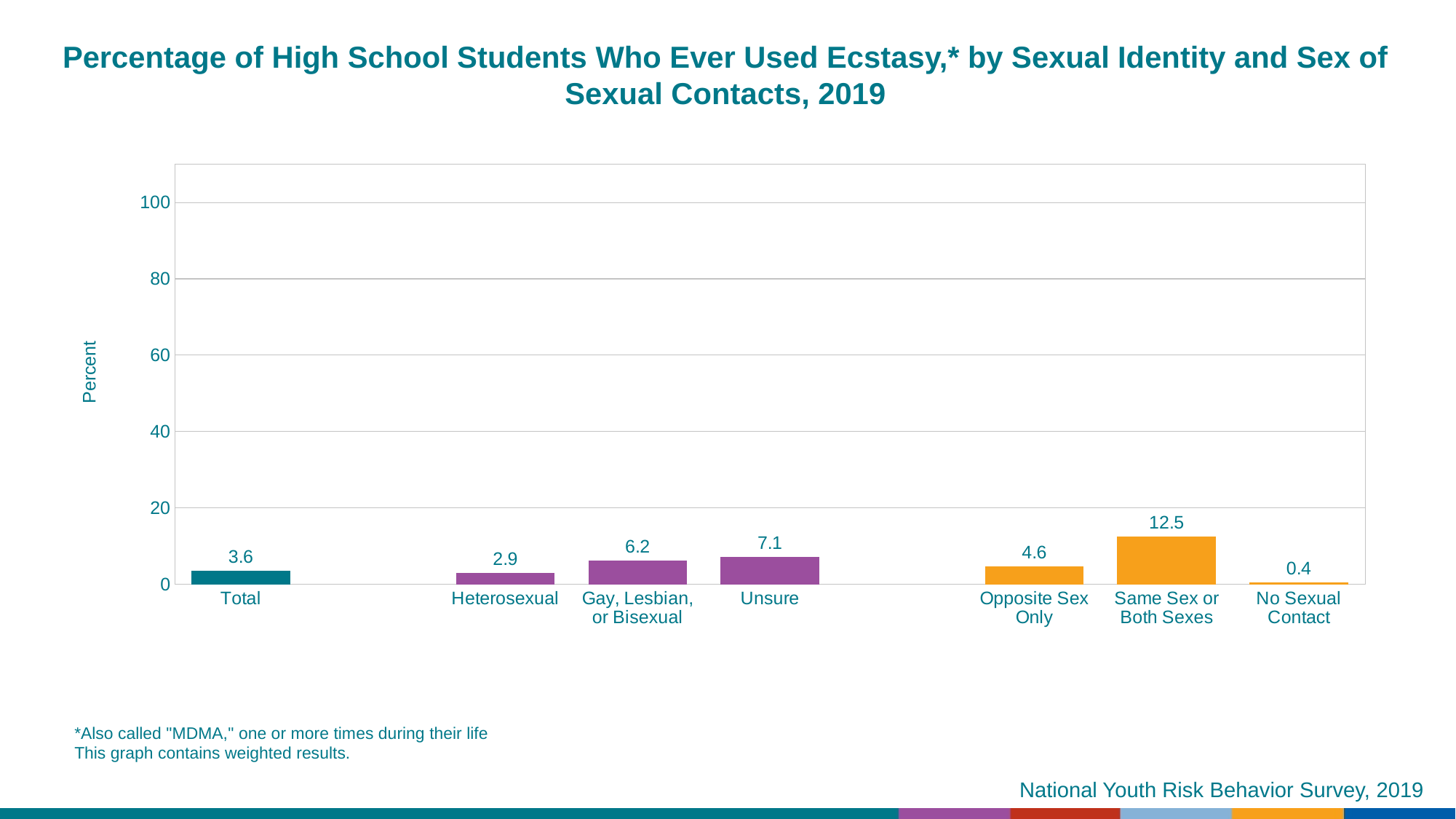
What is the value for Total? 3.6 What is the value for Same Sex or Both Sexes? 12.5 How many categories are shown on the x axis? 7 Which is larger, the value for Gay, Lesbian, or Bisexual or the value for Opposite Sex Only? Gay, Lesbian, or Bisexual Which category has the highest value? Same Sex or Both Sexes What is the difference between the values for Same Sex or Both Sexes and Opposite Sex Only? 7.9 Is the value for Same Sex or Both Sexes greater or less than 20? less What kind of chart is this? bar chart What is the difference between the values for Unsure and Heterosexual? 4.2 What is the value for No Sexual Contact? 0.4 Which category has the lowest value? No Sexual Contact What is the value for Heterosexual? 2.9